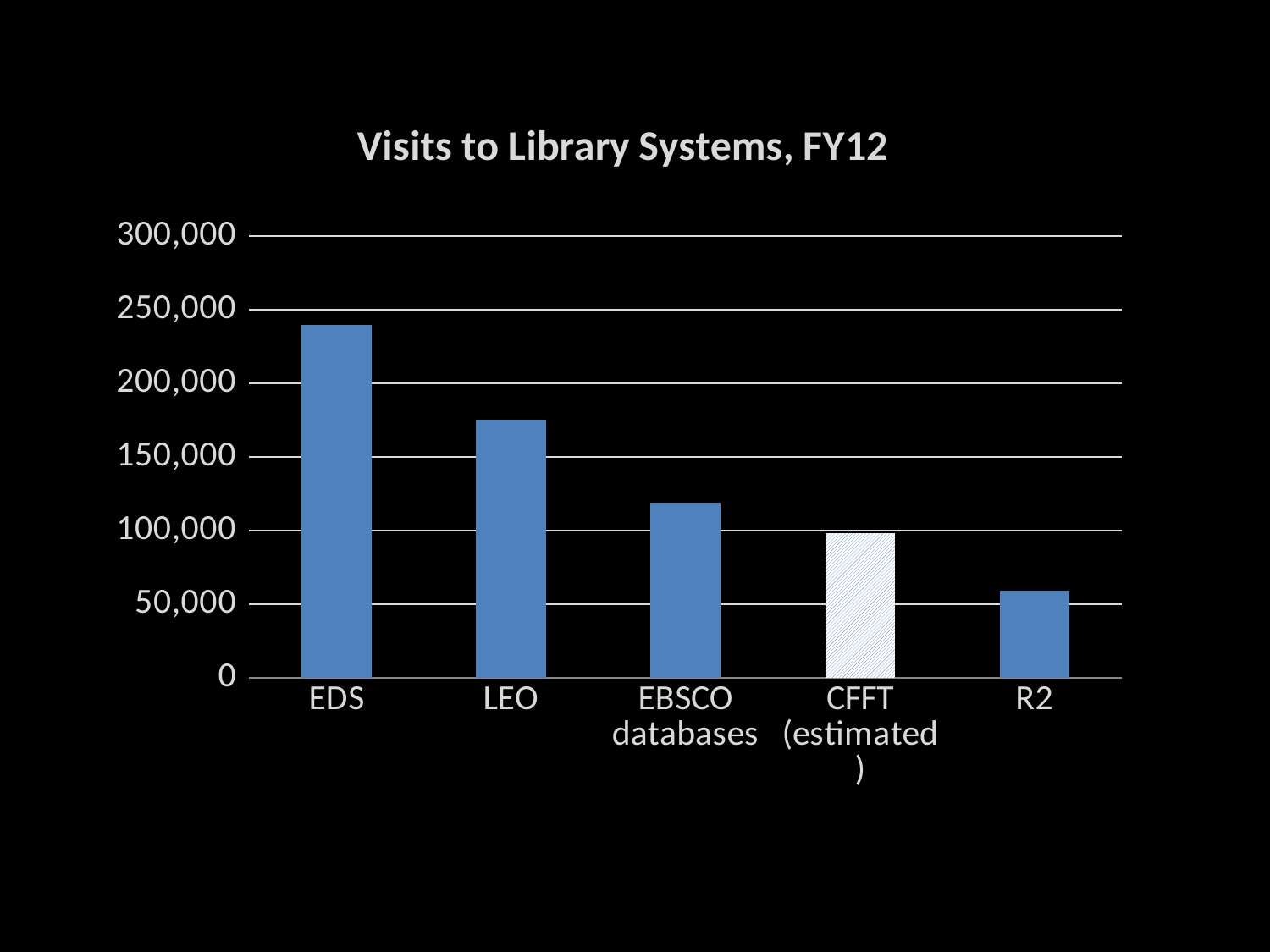
Which has more visits, LEO or EBSCO databases? LEO What type of chart is shown on the slide? bar chart How many library systems are shown on the x axis? 5 What is the title of the chart? Visits to Library Systems, FY12 Is the value for EDS greater or less than 200,000? greater Is the value for EDS greater or less than 250,000? less Which library system has the highest number of visits? EDS Is the value for R2 greater or less than 100,000? less Do the values rise or fall moving from left to right along the x axis? fall Which library system has the lowest number of visits? R2